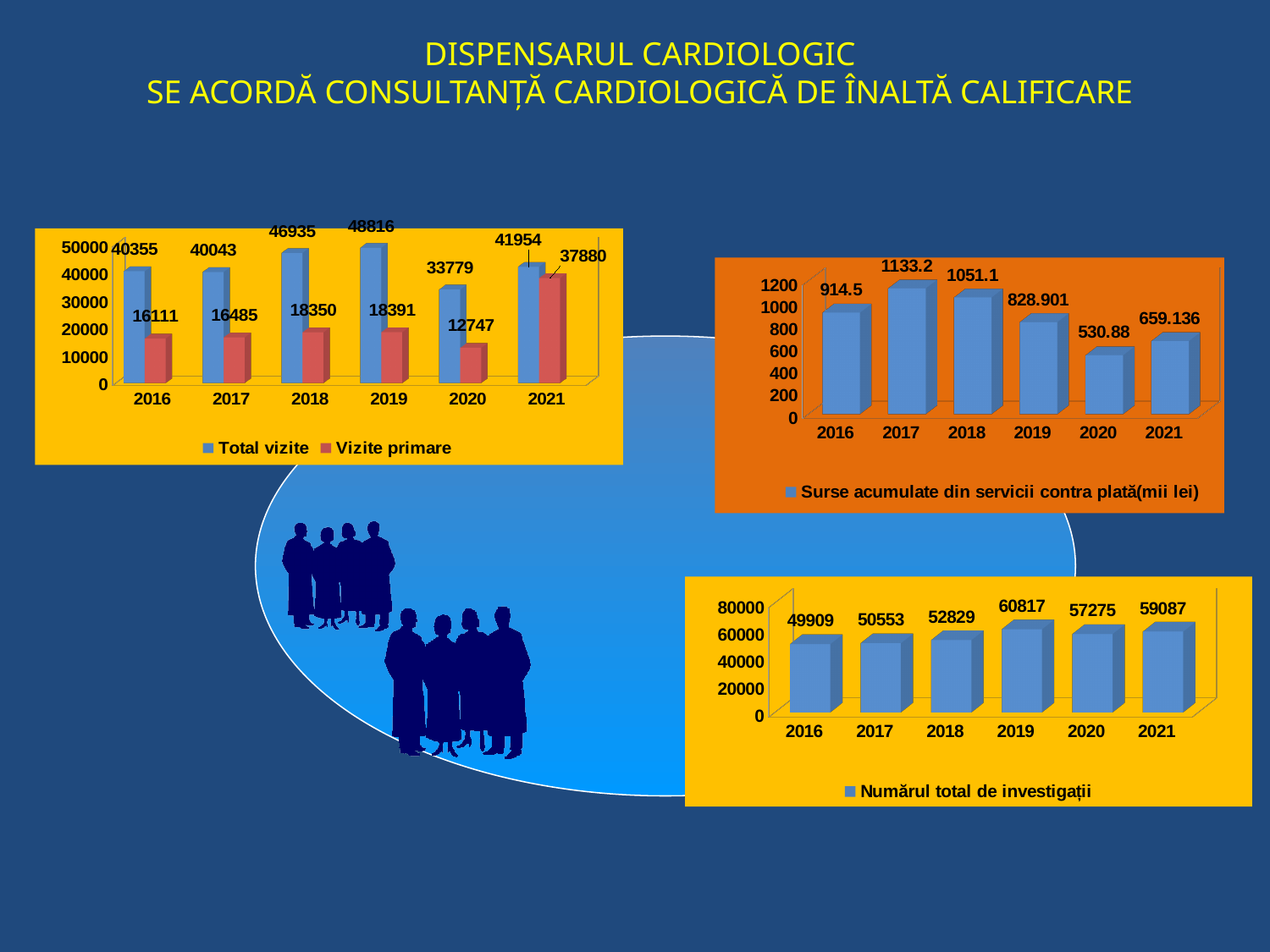
In the bottom-right chart 'Numărul total de investigații', what is the difference between the values for 2021 and 2016? 9178 In the top-left chart with the legend 'Total vizite' and 'Vizite primare', what is the value of Total vizite for 2019? 48816 In the top-left chart with the legend 'Total vizite' and 'Vizite primare', what is the difference between Total vizite and Vizite primare in 2020? 21032 What kind of chart is the bottom-right chart 'Numărul total de investigații'? bar chart In the top-left chart with the legend 'Total vizite' and 'Vizite primare', how many series does the legend list? 2 In the top-left chart with the legend 'Total vizite' and 'Vizite primare', what is the value of Vizite primare for 2021? 37880 In the bottom-right chart 'Numărul total de investigații', what is the value for 2019? 60817 In the top-right chart 'Surse acumulate din servicii contra plată(mii lei)', what is the value for 2017? 1133.2 In the top-right chart 'Surse acumulate din servicii contra plată(mii lei)', which year has the lowest value? 2020 In the top-right chart 'Surse acumulate din servicii contra plată(mii lei)', is the value for 2016 larger or smaller than the value for 2019? larger In the top-left chart with the legend 'Total vizite' and 'Vizite primare', which year has the lowest Total vizite? 2020 In the top-right chart 'Surse acumulate din servicii contra plată(mii lei)', how many years are shown on the x axis? 6